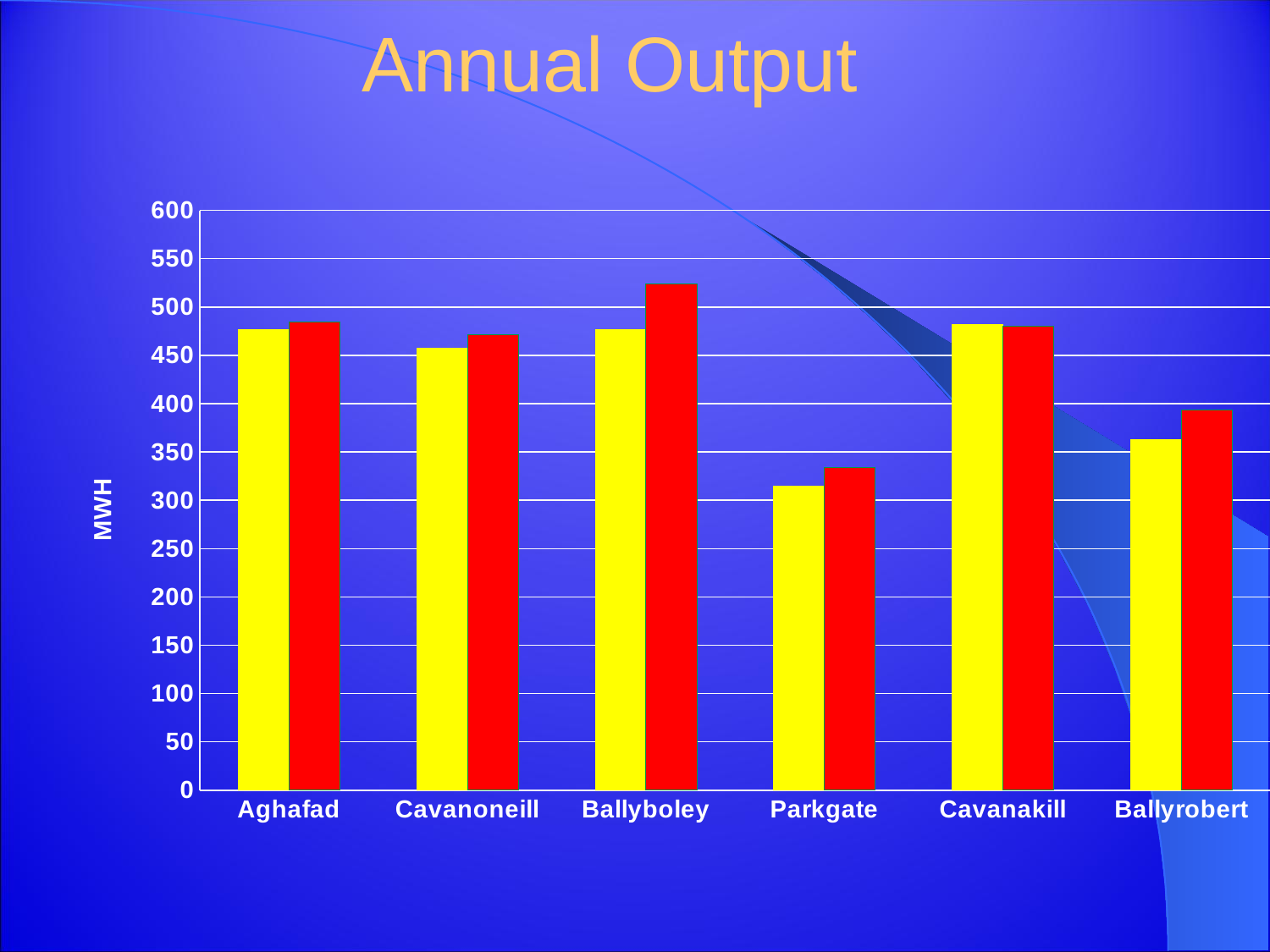
What is the label on the vertical axis of the chart? MWH Is the yellow bar for Parkgate greater or less than 350? less How many categories are shown on the x axis of the chart? 6 Which is larger, the red bar for Ballyboley or the red bar for Parkgate? Ballyboley Is the red bar for Ballyboley greater or less than 500? greater Is the yellow bar for Cavanakill greater or less than 500? less Which category has the tallest red bar? Ballyboley Which category has the shortest yellow bar? Parkgate What kind of chart is shown on the slide? bar chart What is the title of the chart? Annual Output Which category has the shortest red bar? Parkgate